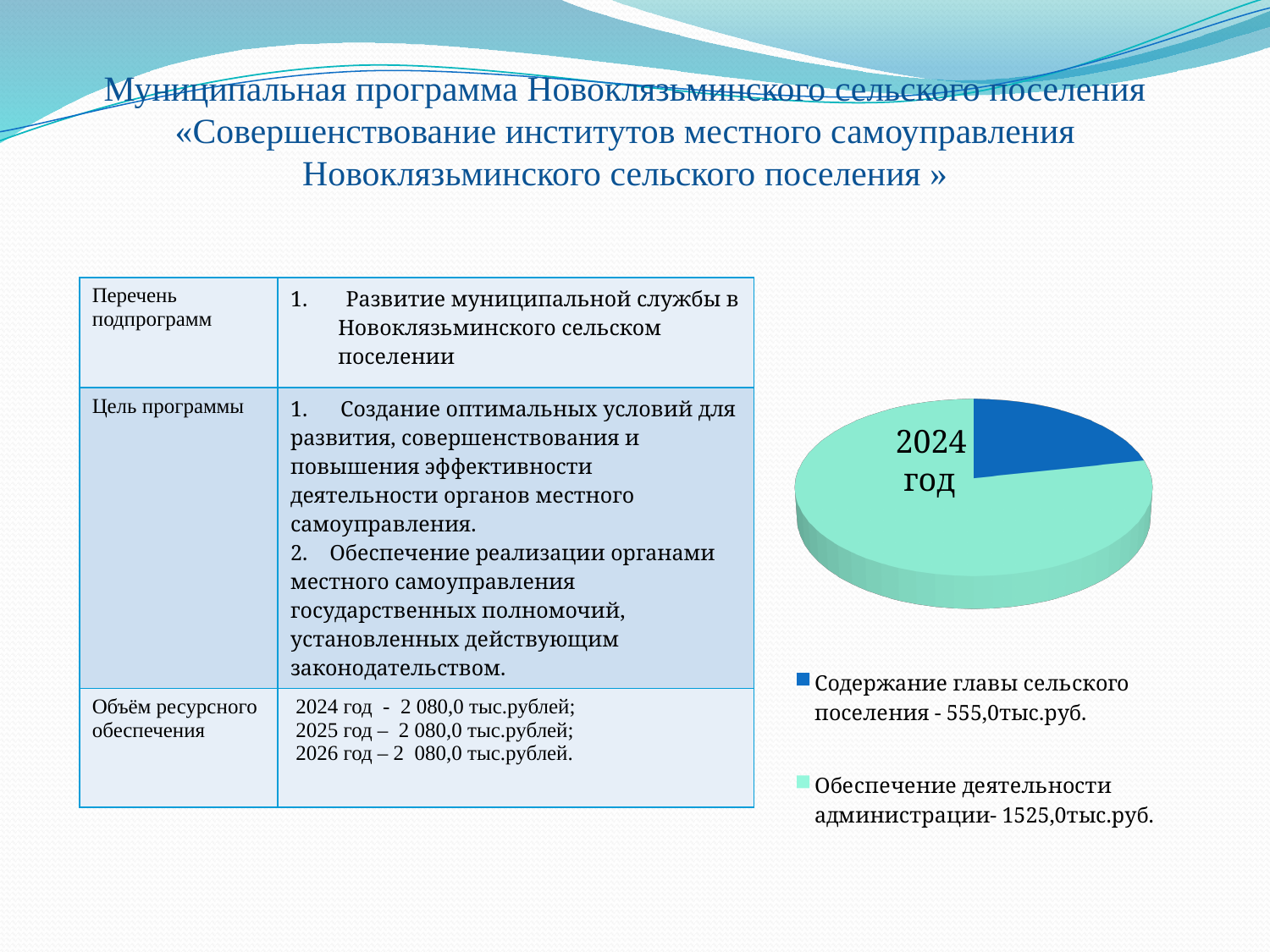
How many slices does the pie chart have? 2 What is the difference between «Обеспечение деятельности администрации» and «Содержание главы сельского поселения» in the pie chart? 970,0 тыс.руб. What value is given for «Содержание главы сельского поселения» in the pie chart legend? 555,0тыс.руб. What colour is the slice for «Содержание главы сельского поселения» in the pie chart? Dark blue What value is given for «Обеспечение деятельности администрации» in the pie chart legend? 1525,0тыс.руб. Which category has the largest slice in the pie chart? Обеспечение деятельности администрации What year label is shown on the pie chart? 2024 год Which category has the smallest slice in the pie chart? Содержание главы сельского поселения Which is larger: «Содержание главы сельского поселения» or «Обеспечение деятельности администрации»? Обеспечение деятельности администрации How many entries does the legend of the pie chart list? 2 What is the total of the two values shown in the pie chart legend? 2080,0 тыс.руб. What kind of chart is shown on the slide? Pie chart